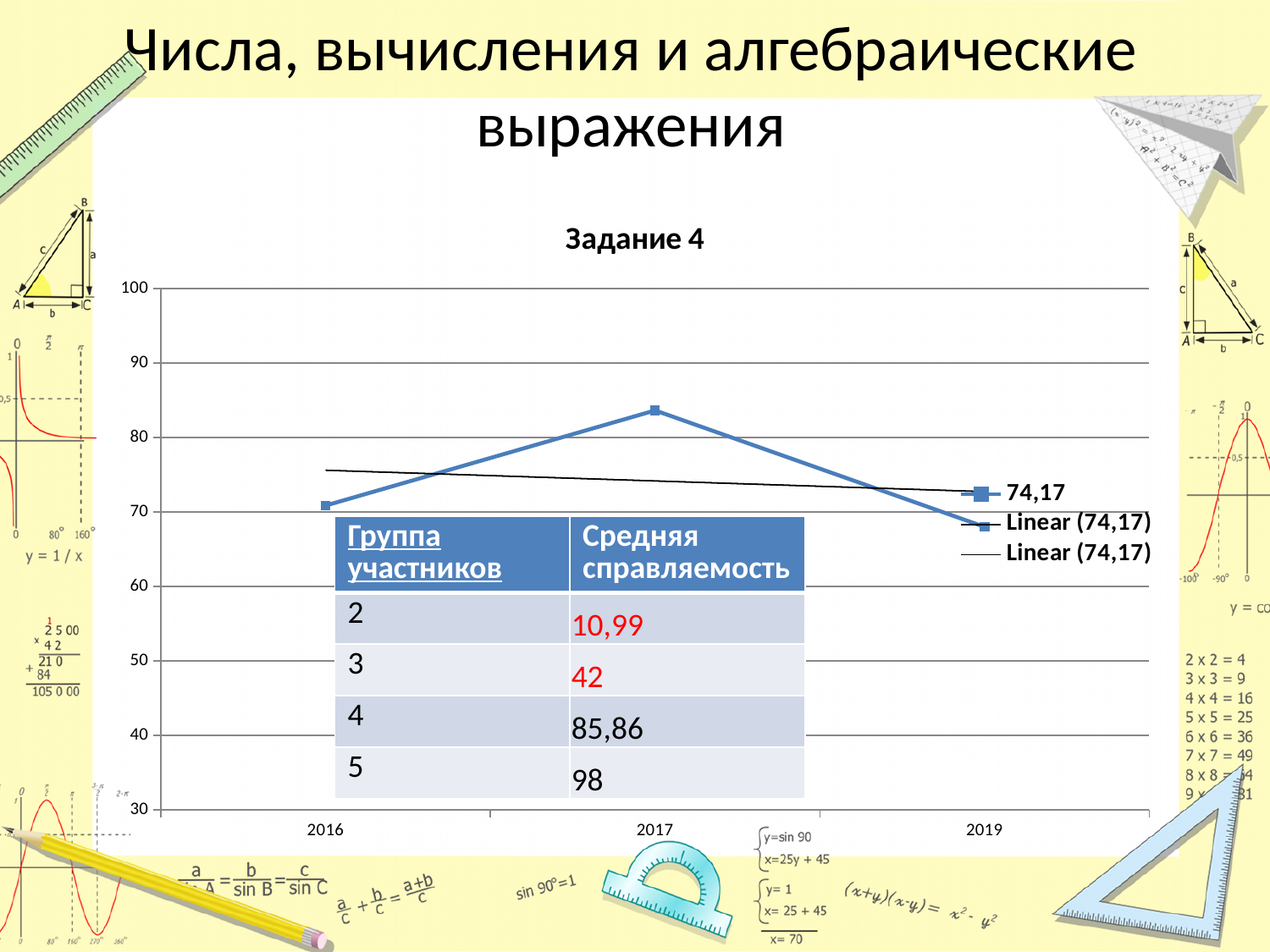
How many data points are plotted on the line in the chart? 3 Is the value for 2017 greater or less than 80? greater What is the title of the chart? Задание 4 In which year does the line reach its lowest value? 2019 Is the value for 2019 greater or less than 70? less What is the name of the data series shown in the legend? 74,17 Does the line rise or fall from 2017 to 2019? fall Which year has the larger value, 2016 or 2019? 2016 In which year does the line reach its highest value? 2017 How many entries does the chart legend list? 3 What kind of chart is shown on the slide? line chart